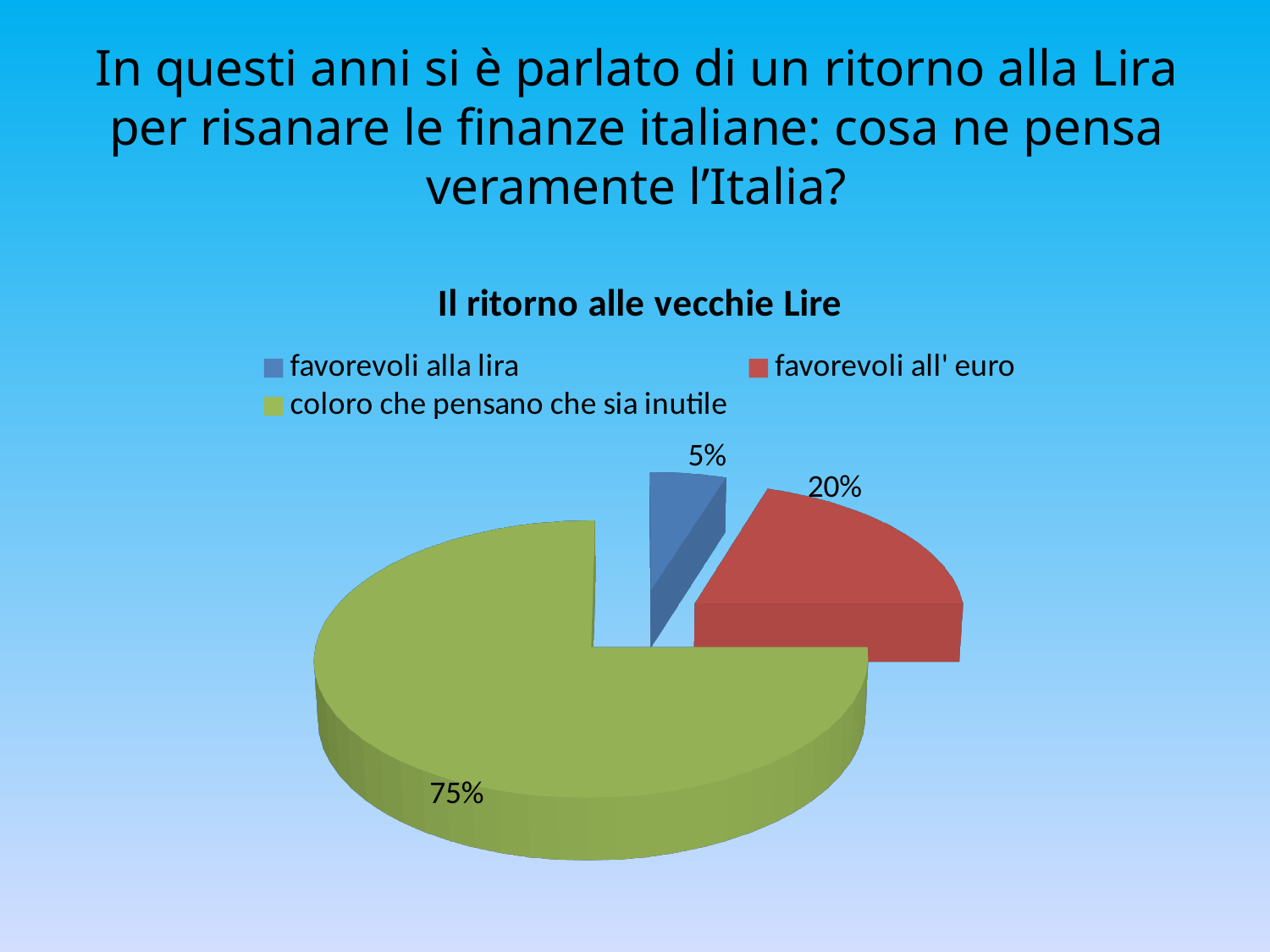
Which category has the largest slice? coloro che pensano che sia inutile Which category has the smallest slice? favorevoli alla lira What colour is the slice for 'favorevoli all' euro'? red What share of the pie is 'favorevoli alla lira'? 5% What type of chart is shown on the slide? pie chart How many entries does the legend list? 3 What is the title of the chart? Il ritorno alle vecchie Lire What share of the pie is 'favorevoli all' euro'? 20% What share of the pie is 'coloro che pensano che sia inutile'? 75% Which is larger, 'favorevoli all' euro' or 'favorevoli alla lira'? favorevoli all' euro How many slices does the pie chart have? 3 What is the difference in percentage points between 'coloro che pensano che sia inutile' and 'favorevoli all' euro'? 55